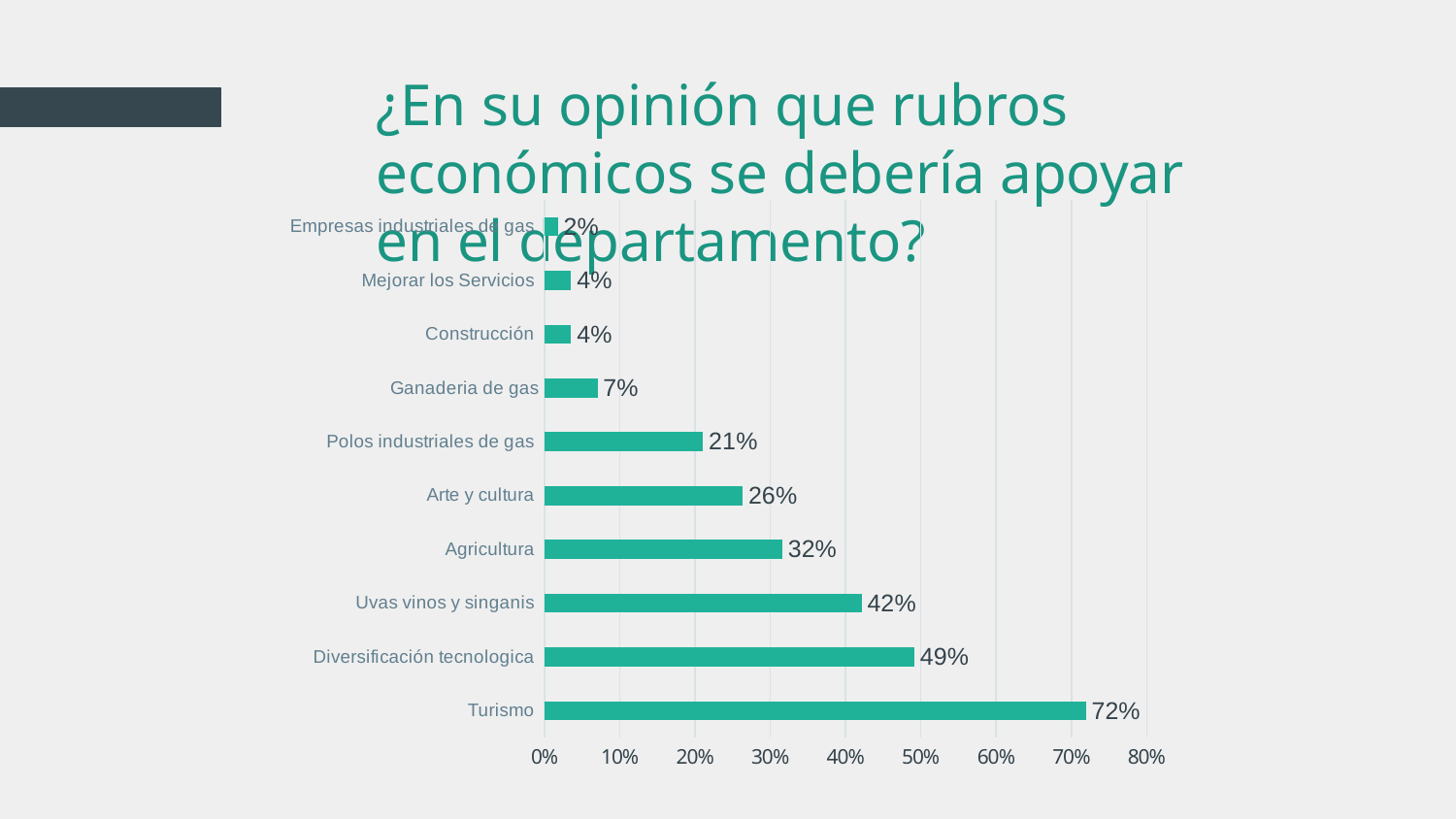
Which category has the highest value? Turismo What is the difference between the values for Turismo and Diversificación tecnologica? 23% What is the value for Diversificación tecnologica? 49% What kind of chart is shown on the slide? Bar chart How many categories are shown in the chart? 10 What is the difference between the values for Uvas vinos y singanis and Arte y cultura? 16% Which is larger, the value for Agricultura or the value for Arte y cultura? Agricultura What is the value for Agricultura? 32% What is the value for Turismo? 72% What is the highest value shown on the horizontal axis? 80% What is the value for Polos industriales de gas? 21% Which category has the lowest value? Empresas industriales de gas